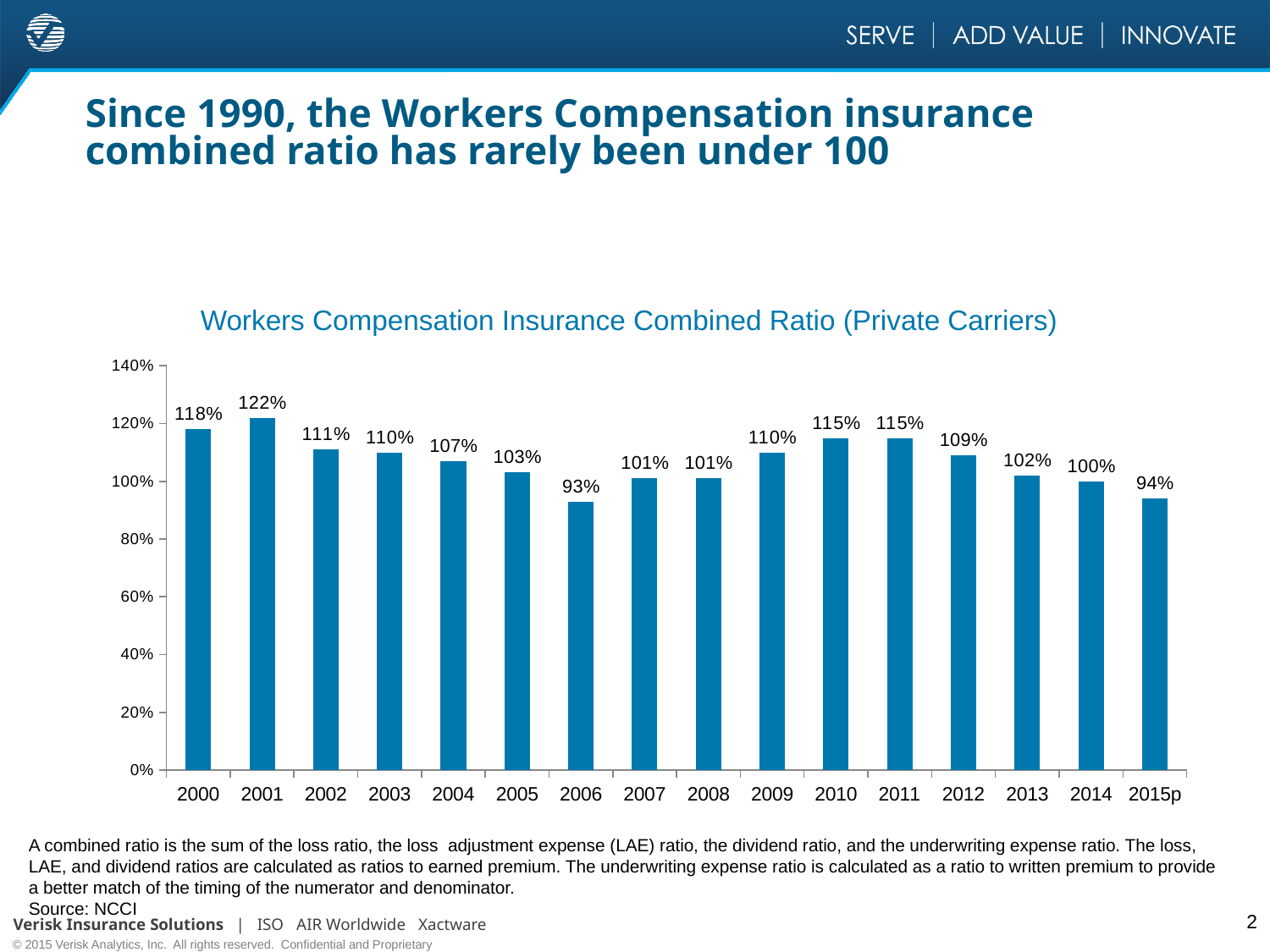
How many years are shown on the x axis? 16 Which year has the highest combined ratio? 2001 Do the values rise or fall from 2011 to 2015p? fall What is the title of the chart? Workers Compensation Insurance Combined Ratio (Private Carriers) Which year has a higher combined ratio, 2009 or 2012? 2009 What is the combined ratio for 2001? 122% Is the value for 2013 greater or less than 100%? greater What is the difference between the combined ratio in 2000 and in 2014? 18% Which year has the lowest combined ratio? 2006 What is the combined ratio for 2015p? 94% What is the combined ratio for 2006? 93% What kind of chart is shown on the slide? bar chart